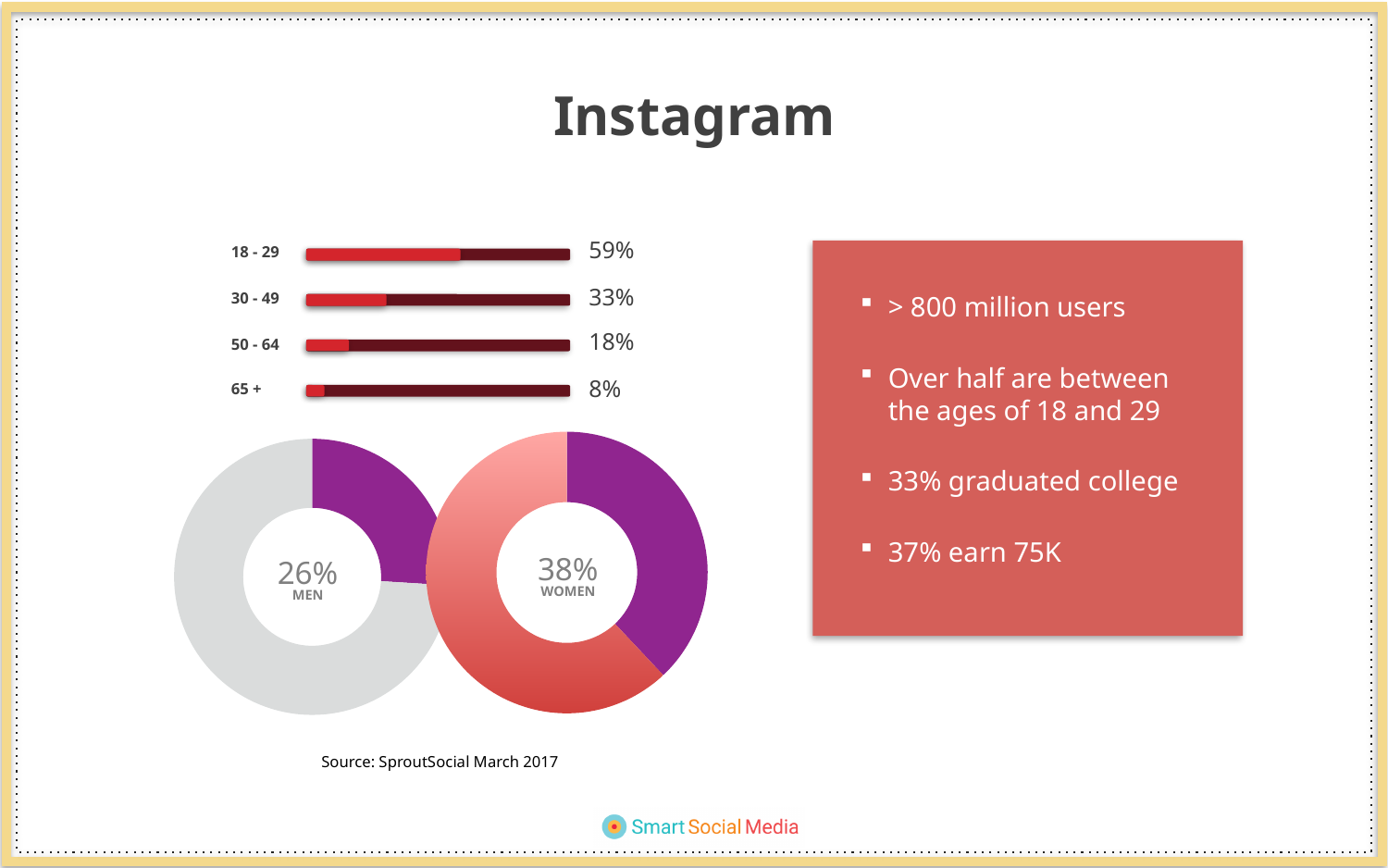
In the age-group bar chart, what percentage is shown for the 65 + group? 8% In the age-group bar chart, which age group has the lowest percentage? 65 + In the age-group bar chart, what is the difference between the 18 - 29 and 30 - 49 percentages? 26% In the age-group bar chart, what percentage is shown for the 18 - 29 group? 59% In the age-group bar chart, which age group has the highest percentage? 18 - 29 In the donut charts, what percentage is shown for Men? 26% In the age-group bar chart, which is larger: the 50 - 64 value or the 65 + value? 50 - 64 In the donut charts, what is the difference between the Women and Men percentages? 12% How many age groups are shown in the age-group bar chart? 4 What kind of chart is used to show the age groups? Bar chart In the age-group bar chart, what percentage is shown for the 30 - 49 group? 33% In the age-group bar chart, what percentage is shown for the 50 - 64 group? 18%